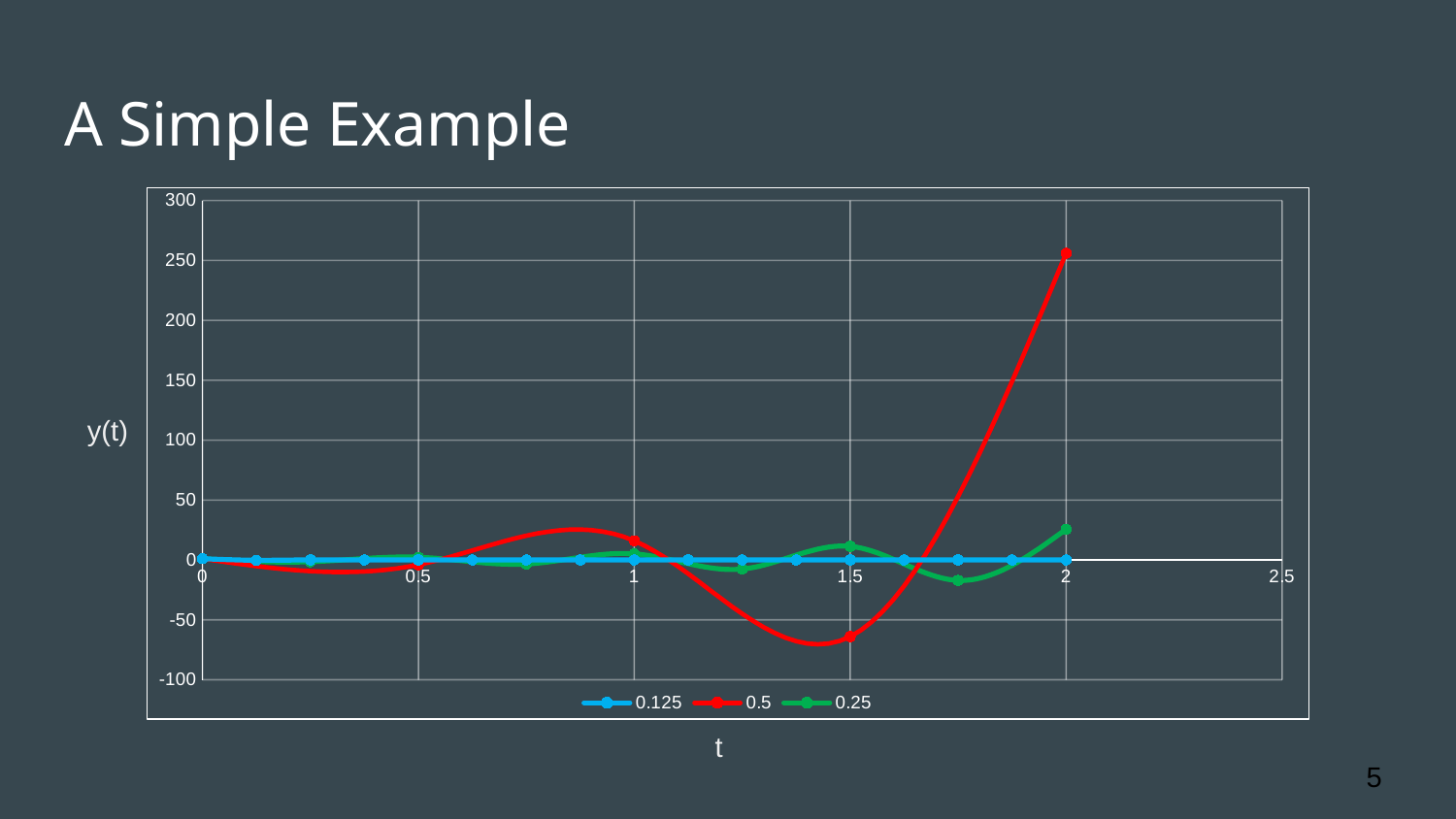
At t = 2, which series has the larger value, 0.5 or 0.25? 0.5 What kind of chart is shown on the slide? line chart Is the value of the 0.5 series at t = 2 greater or less than 200? greater How many series does the legend list? 3 Does the 0.5 series rise or fall between t = 1.5 and t = 2? rise What is the label of the vertical axis? y(t) Is the value of the 0.5 series at t = 1.5 greater or less than -50? less Is the value of the 0.5 series at t = 1 greater or less than 0? greater What are the three series names in the legend? 0.125, 0.5, 0.25 Which series has the highest value at t = 2? 0.5 Which series has the lowest value at t = 1.5? 0.5